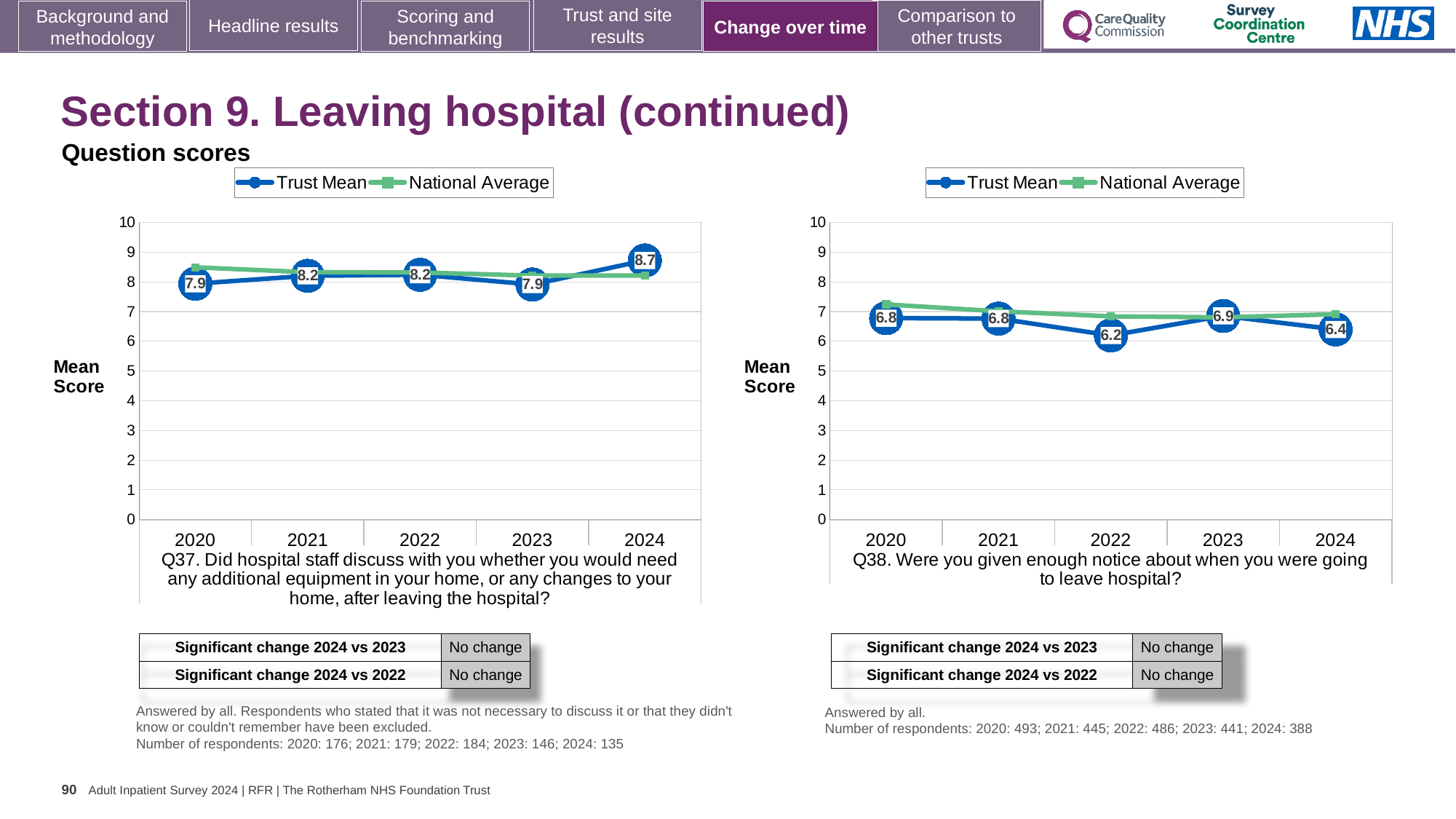
On the Q38 chart (right), is the Trust Mean score for 2024 larger or smaller than the score for 2023? smaller On the Q37 chart (left), what is the Trust Mean score for 2024? 8.7 On the Q38 chart (right), is the National Average value for 2020 greater or less than 6? greater On the Q37 chart (left), how many series does the legend list? 2 On the Q38 chart (right), what is the Trust Mean score for 2022? 6.2 On the Q37 chart (left), what is the difference between the Trust Mean scores for 2024 and 2023? 0.8 On the Q37 chart (left), which year has the highest Trust Mean score? 2024 On the Q38 chart (right), what is the Trust Mean score for 2023? 6.9 On the Q38 chart (right), which year has the lowest Trust Mean score? 2022 What kind of chart is the Q37 chart (left)? line chart On the Q37 chart (left), what is the Trust Mean score for 2020? 7.9 On the Q38 chart (right), how many years are shown on the x axis? 5